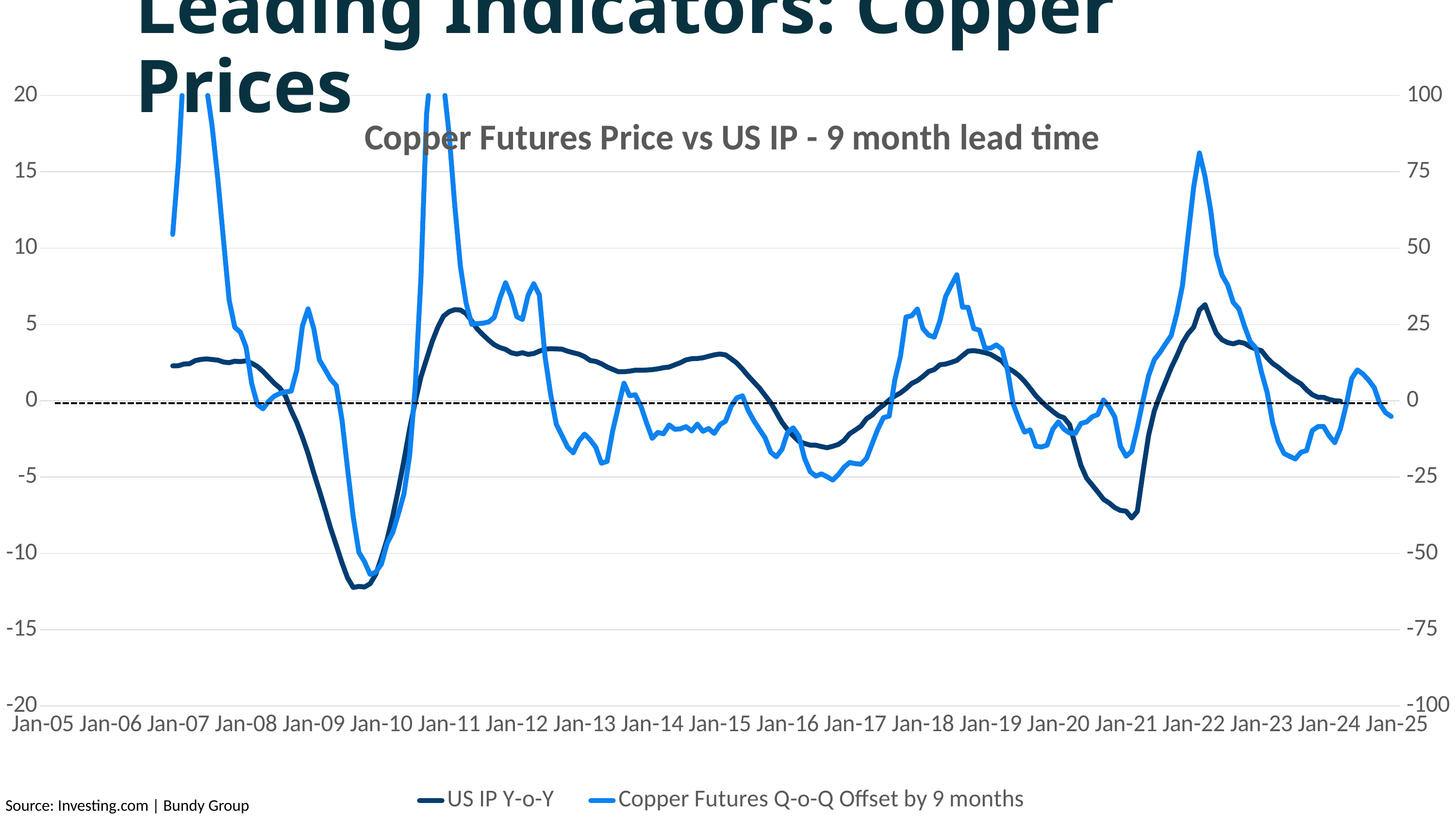
Is the lowest value of the US IP Y-o-Y line, reached around 2009, greater or less than -10 on the left axis? less What kind of chart is shown on the slide? Line chart Does the US IP Y-o-Y line rise or fall between Jan-08 and Jan-09? fall Is the peak of the US IP Y-o-Y line around Jan-22 greater or less than 5 on the left axis? greater Which series is drawn in the lighter blue line? Copper Futures Q-o-Q Offset by 9 months Does the Copper Futures Q-o-Q Offset by 9 months line rise or fall between Jan-22 and Jan-23? fall How many year labels are shown on the x axis, from Jan-05 to Jan-25? 21 Is the trough of the US IP Y-o-Y line around Jan-21 greater or less than -5 on the left axis? less What is the title of the chart? Copper Futures Price vs US IP - 9 month lead time How many series does the legend list? 2 Does the US IP Y-o-Y line rise or fall between Jan-21 and Jan-22? rise